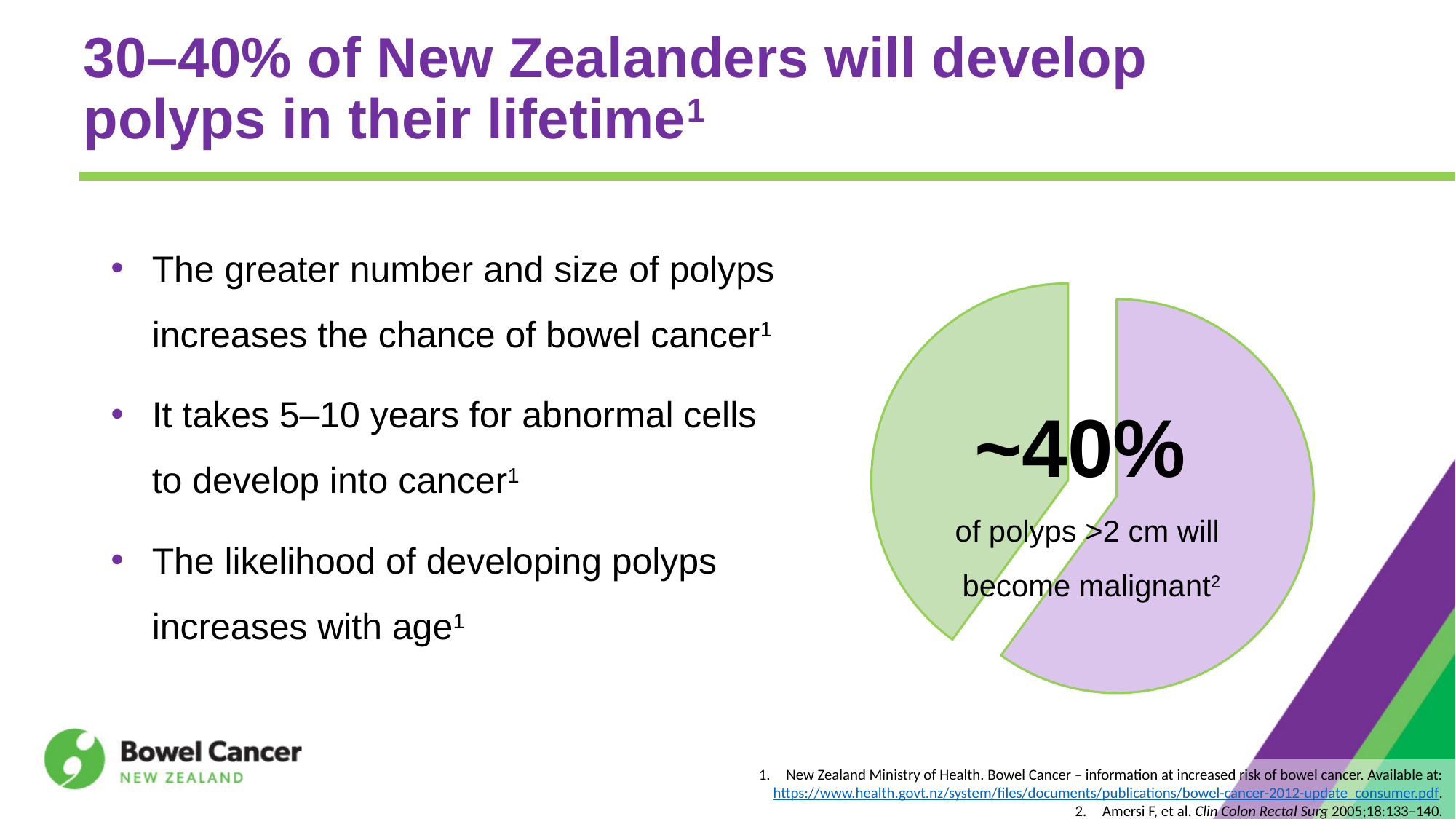
What two colours are used for the slices of the pie chart? green and purple Which slice of the pie chart is larger, the green one or the purple one? the purple one How many slices does the pie chart have? 2 According to the text on the pie chart, what does the ~40% figure represent? of polyps >2 cm will become malignant What percentage is printed on the pie chart? ~40% Which slice of the pie chart is smaller, the green one or the purple one? the green one What kind of chart is shown on the right side of the slide? pie chart